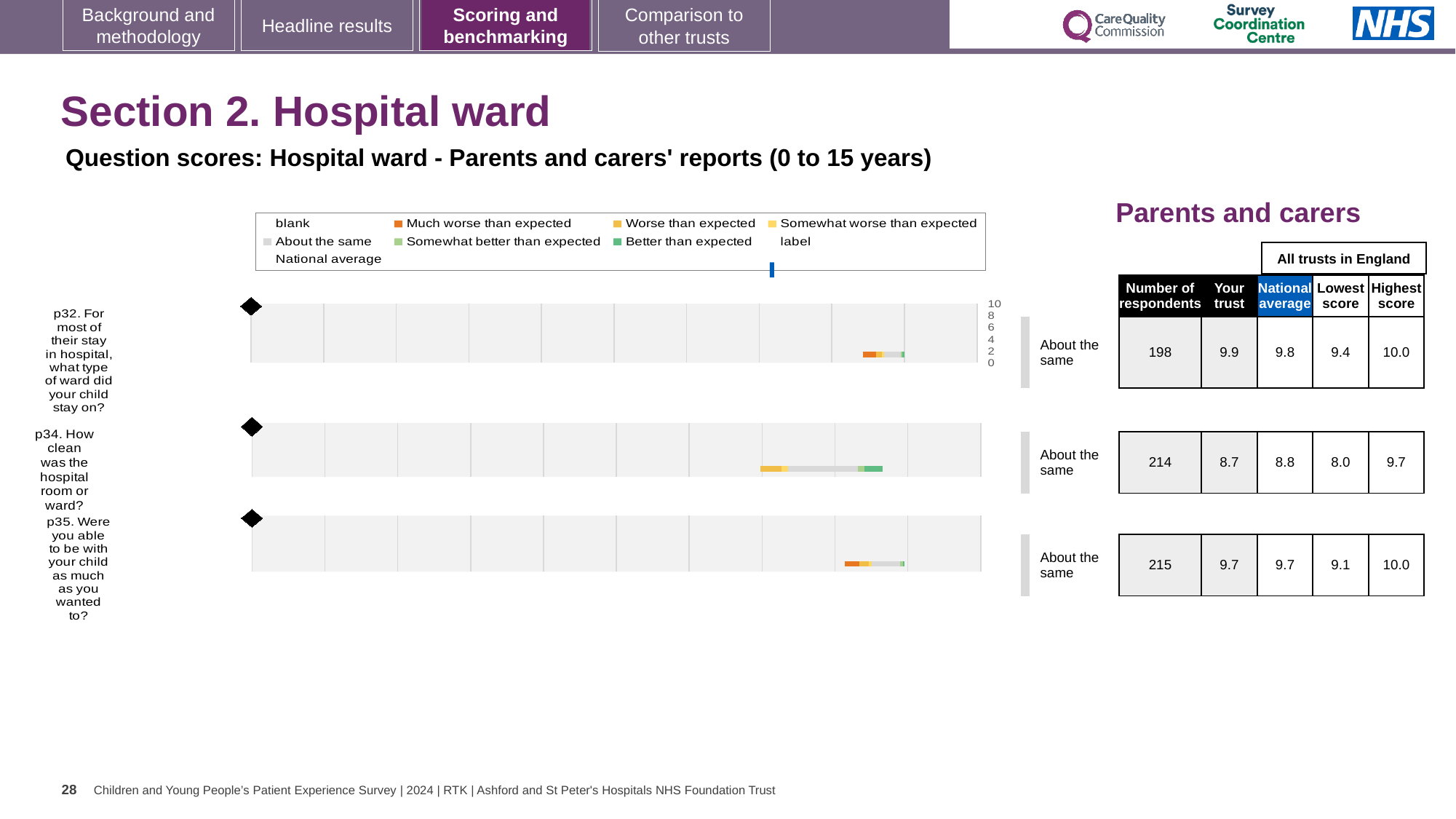
Is the 'Your trust' score for p32 larger or smaller than the national average for p32? larger What benchmark category is shown next to each of the three charts? About the same Which of the three questions has the lowest 'Your trust' score? p34 What kind of chart is used to show the question scores on this slide? bar chart Which legend entry is shown in orange? Much worse than expected How many questions (p32, p34, p35) have a bar chart on this slide? 3 Which legend entry is shown in dark green? Better than expected What is the 'Your trust' score for p32 (what type of ward did your child stay on)? 9.9 What is the national average for p34 (how clean was the hospital room or ward)? 8.8 What is the difference between the highest score and the lowest score for p34? 1.7 Which of the three questions has the highest 'Your trust' score? p32 What is the number of respondents for p35 (were you able to be with your child as much as you wanted to)? 215